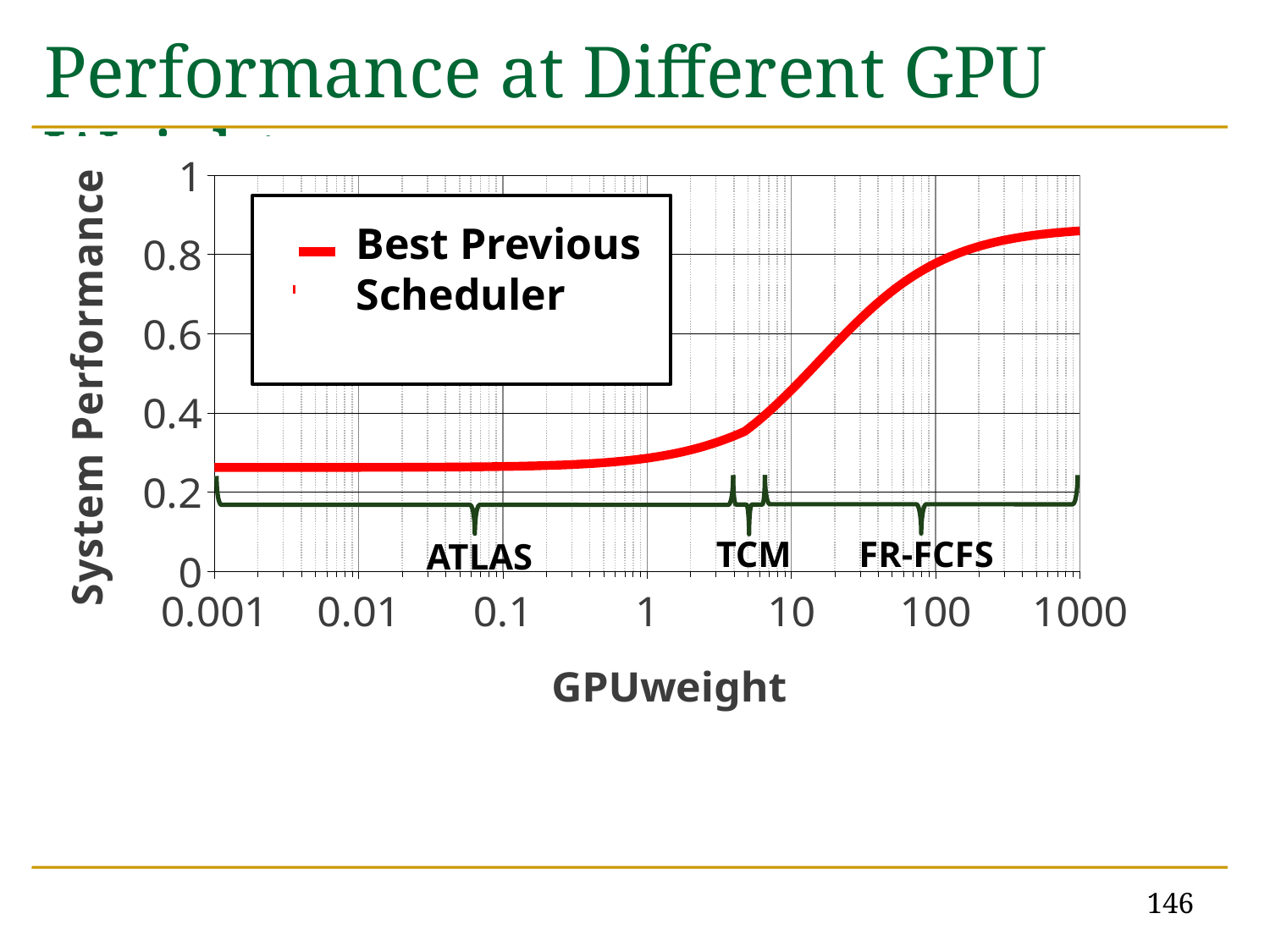
What kind of chart is shown on the slide? line chart Is the System Performance value at GPUweight 1000 greater or less than 0.8? greater Is the System Performance value at GPUweight 1 greater or less than 0.4? less What is the label of the x axis? GPUweight Which scheduler name is written under the bracket covering the lowest GPUweight range? ATLAS Which has the higher System Performance: GPUweight 0.01 or GPUweight 100? GPUweight 100 Does the System Performance curve rise or fall as GPUweight increases from 0.001 to 1000? rise Is the System Performance value at GPUweight 0.001 greater or less than 0.2? greater What is the label of the y axis? System Performance